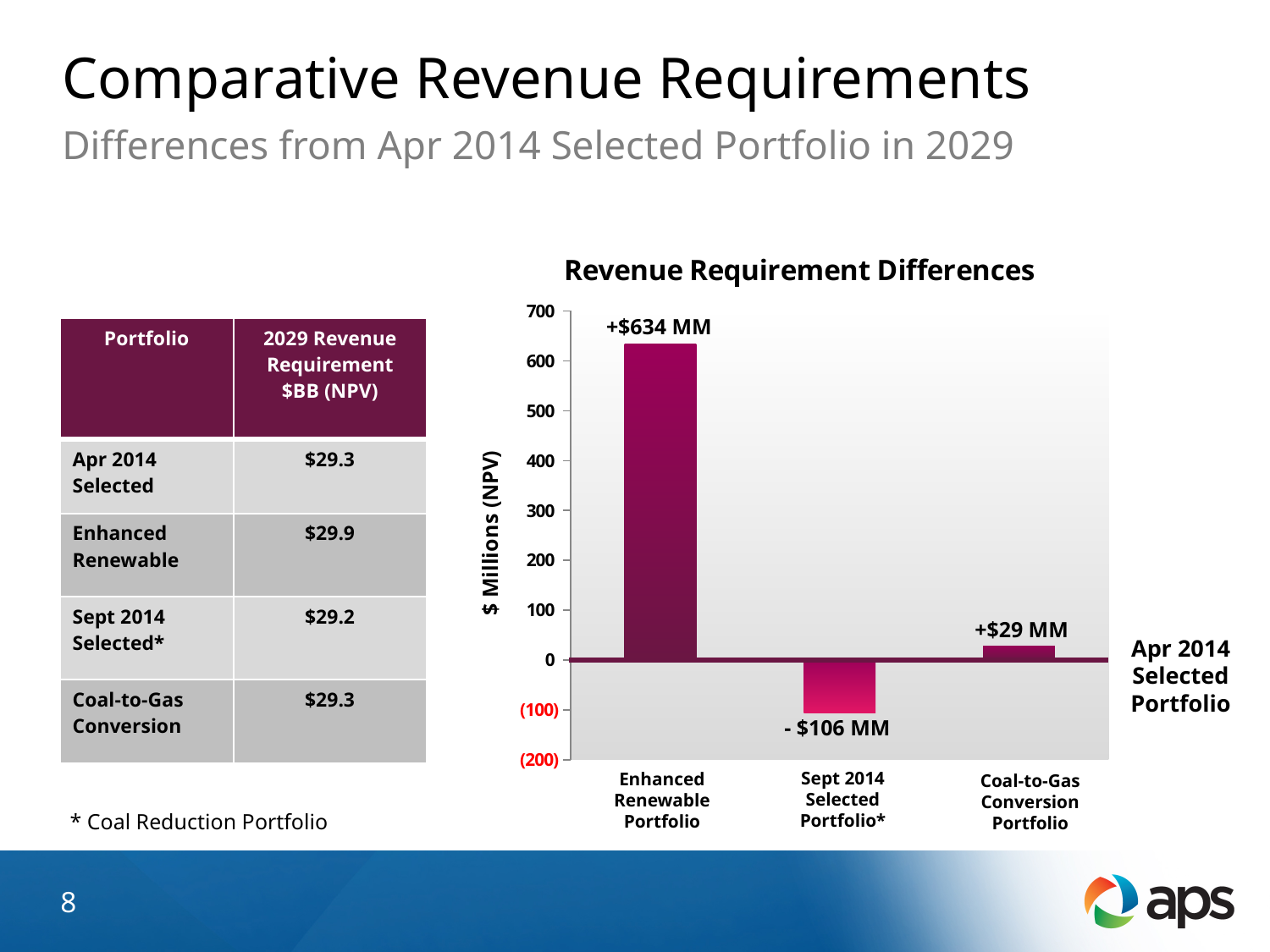
Which is larger in the chart: the value for the Coal-to-Gas Conversion Portfolio or the value for the Sept 2014 Selected Portfolio*? Coal-to-Gas Conversion Portfolio What is the difference between the Enhanced Renewable Portfolio value and the Coal-to-Gas Conversion Portfolio value in the chart? $605 MM What is the y-axis label of the Revenue Requirement Differences chart? $ Millions (NPV) Which portfolio has the highest revenue requirement difference in the chart? Enhanced Renewable Portfolio Which portfolio has the lowest revenue requirement difference in the chart? Sept 2014 Selected Portfolio* What is the title of the chart on the slide? Revenue Requirement Differences What is the value for the Coal-to-Gas Conversion Portfolio in the Revenue Requirement Differences chart? +$29 MM How many portfolios are plotted in the Revenue Requirement Differences chart? 3 What kind of chart is the Revenue Requirement Differences chart? bar chart What is the value for the Enhanced Renewable Portfolio in the Revenue Requirement Differences chart? +$634 MM What is the value for the Sept 2014 Selected Portfolio* in the Revenue Requirement Differences chart? - $106 MM Is the value for the Enhanced Renewable Portfolio greater or less than 600 in the chart? greater